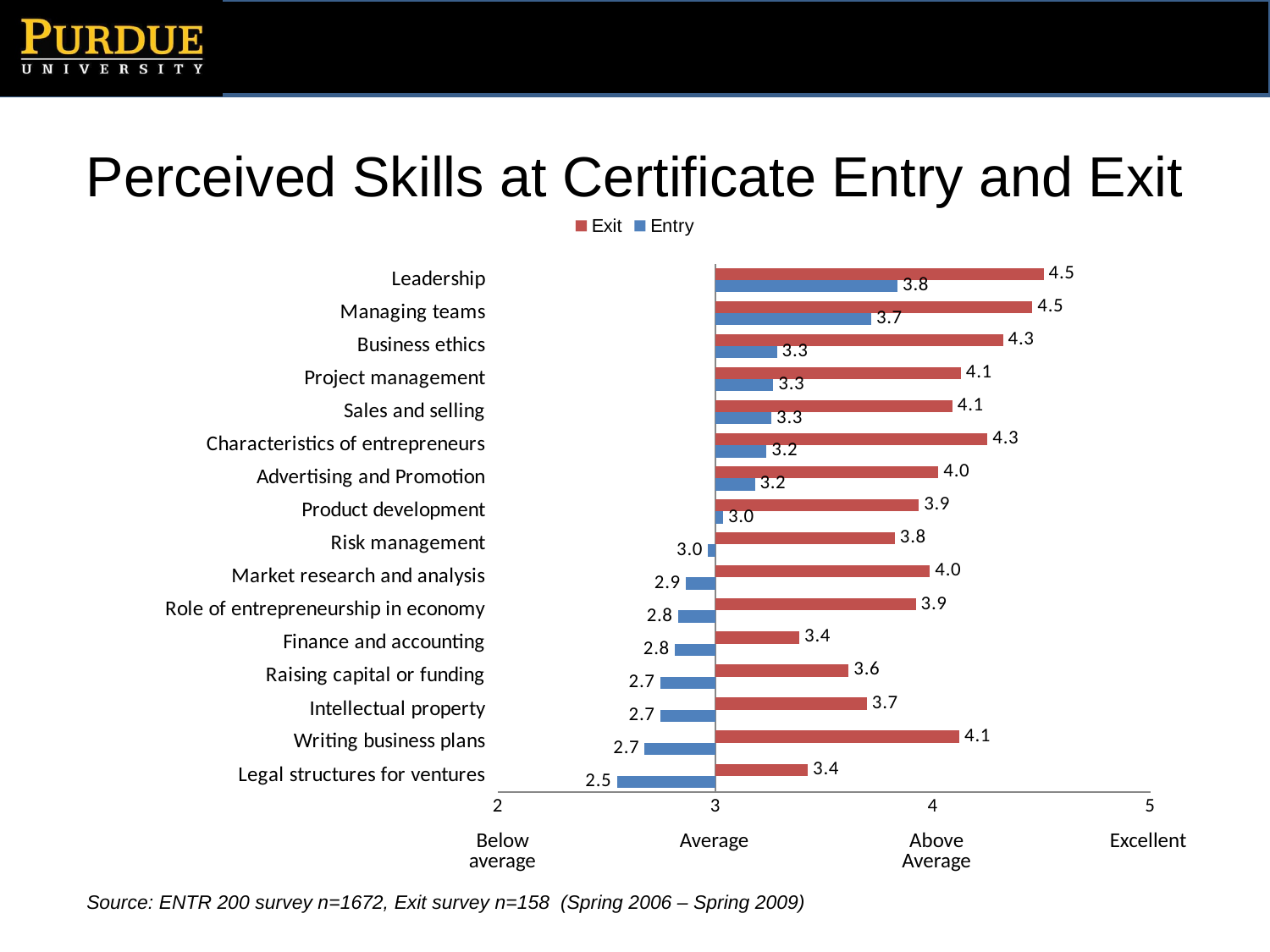
What kind of chart is shown on the slide? Bar chart What is the Entry value for Writing business plans? 2.7 What is the difference between the Exit and Entry values for Writing business plans? 1.4 How many series does the legend list? 2 Which category has the lowest Entry value? Legal structures for ventures Which category has the highest Entry value? Leadership What is the title of the chart on the slide? Perceived Skills at Certificate Entry and Exit Which is larger, the Exit value for Raising capital or funding or the Exit value for Finance and accounting? Raising capital or funding What is the Exit value for Intellectual property? 3.7 What is the difference between the Exit and Entry values for Leadership? 0.7 How many skill categories are shown in the chart? 16 What is the Exit value for Business ethics? 4.3